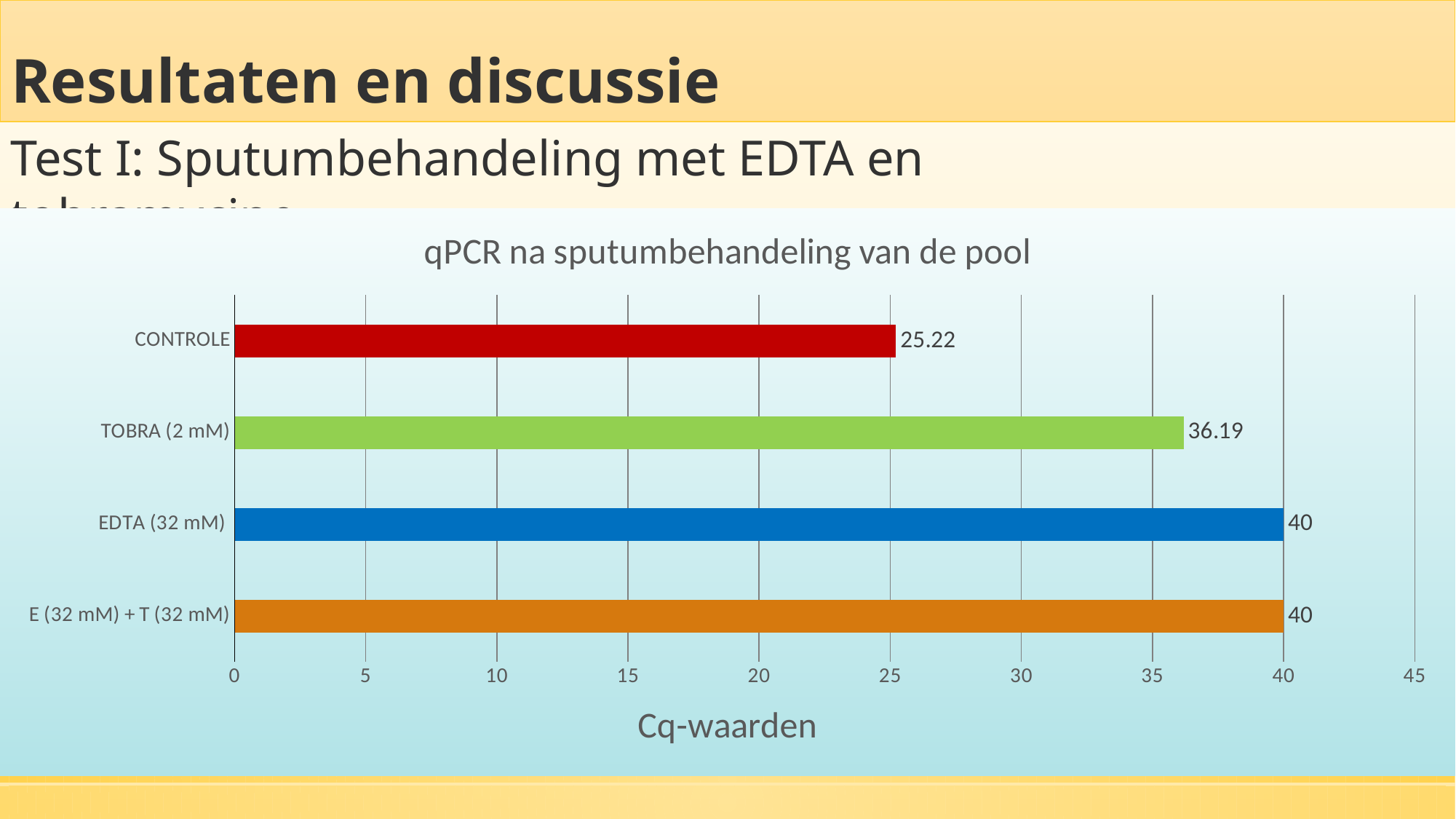
Is the value for TOBRA (2 mM) greater or less than 30? greater Which has a larger Cq value, CONTROLE or TOBRA (2 mM)? TOBRA (2 mM) What is the Cq value for CONTROLE? 25.22 Which category has the lowest Cq value? CONTROLE What is the title of the chart? qPCR na sputumbehandeling van de pool What is the Cq value for TOBRA (2 mM)? 36.19 What is the Cq value for EDTA (32 mM)? 40 What kind of chart is shown on the slide? bar chart What is the difference between the Cq values of EDTA (32 mM) and TOBRA (2 mM)? 3.81 What is the label of the x axis? Cq-waarden How many categories are shown in the chart? 4 What is the difference between the Cq values of TOBRA (2 mM) and CONTROLE? 10.97